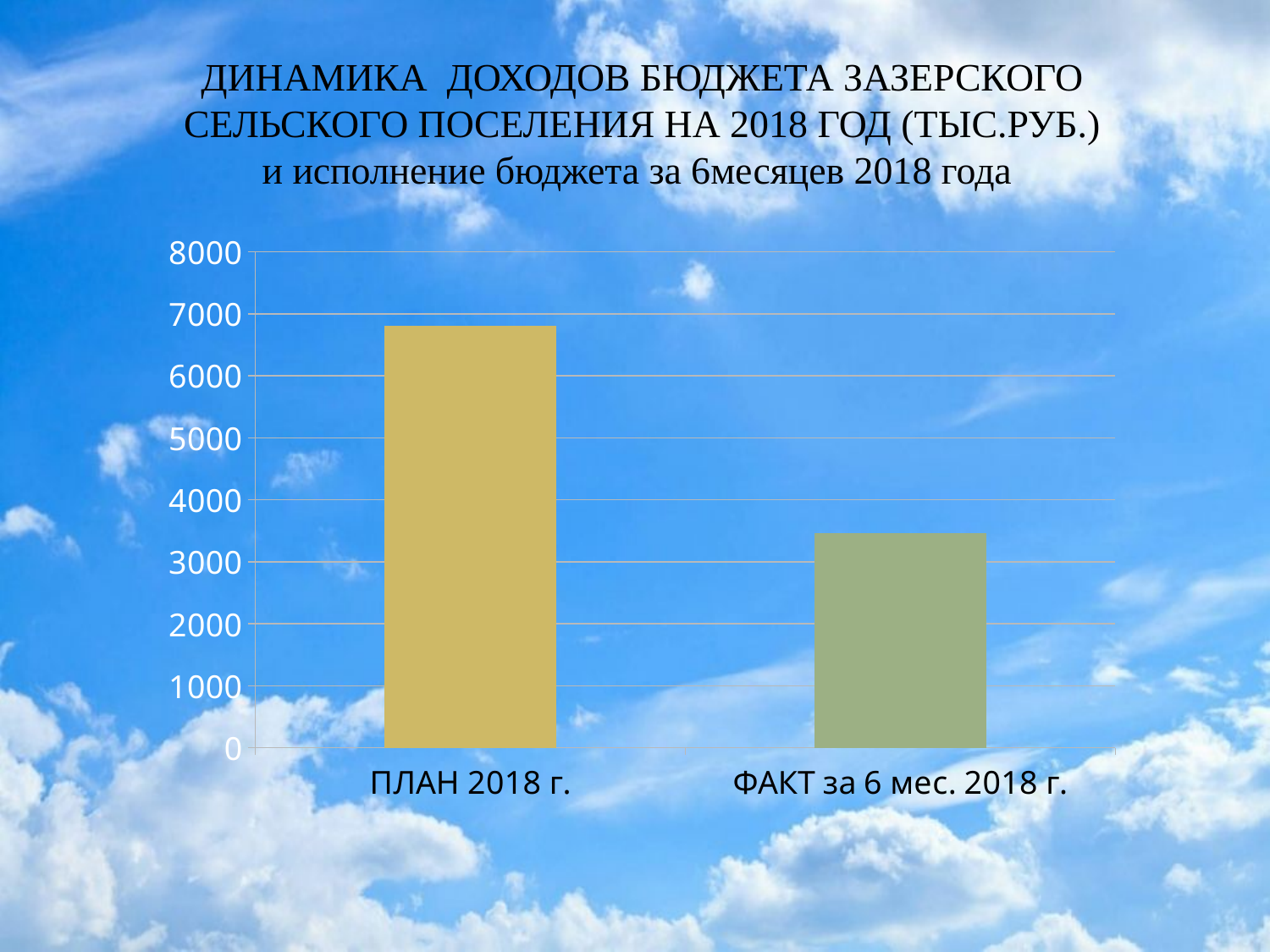
Is the value for ФАКТ за 6 мес. 2018 г. greater or less than 3000? greater What is the highest value shown on the vertical axis? 8000 Which is larger, the value for ПЛАН 2018 г. or the value for ФАКТ за 6 мес. 2018 г.? ПЛАН 2018 г. Is the value for ПЛАН 2018 г. greater or less than 7000? less Is the value for ФАКТ за 6 мес. 2018 г. greater or less than 4000? less Which category has the lowest value? ФАКТ за 6 мес. 2018 г. Do the values rise or fall from the left bar to the right bar? fall Which category has the highest value? ПЛАН 2018 г. What kind of chart is shown on the slide? bar chart In what units are the budget revenues given according to the slide title? тыс.руб. How many bars (categories) does the chart show? 2